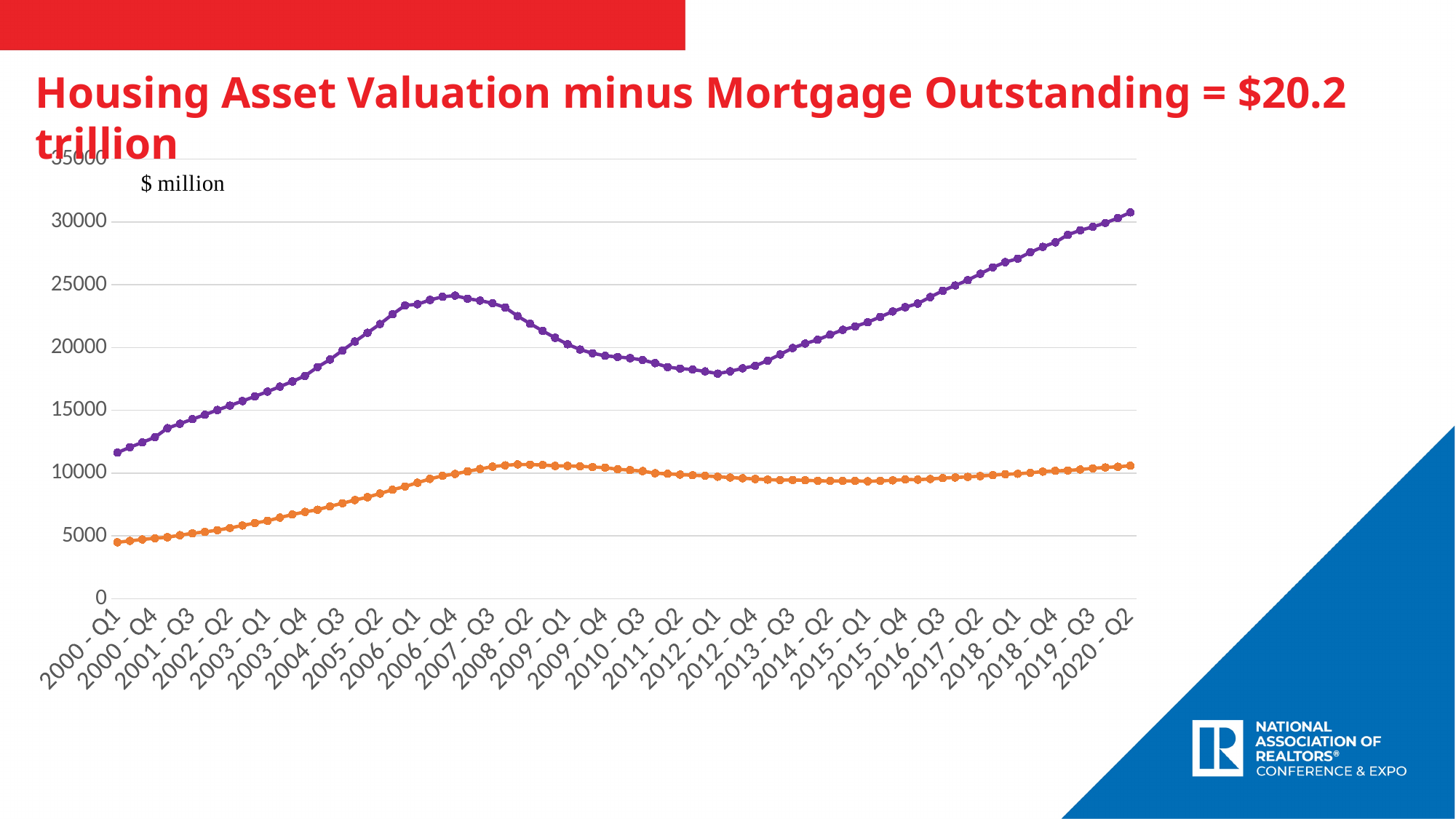
Which line is higher at 2020 - Q2, the purple line or the orange line? the purple line Is the peak of the purple line around 2006 - Q4 greater or less than 25000? less Is the value of the orange line at 2000 - Q1 greater or less than 5000? less What kind of chart is shown on the slide? line chart What unit label is shown at the top left of the chart's plot area? $ million Is the value of the purple line at 2000 - Q1 greater or less than 15000? less What is the title of the slide above the chart? Housing Asset Valuation minus Mortgage Outstanding = $20.2 trillion At which quarter does the purple line reach its highest value? 2020 - Q2 How many lines (series) are plotted on the chart? 2 Does the purple line rise or fall between 2012 - Q1 and 2020 - Q2? rise